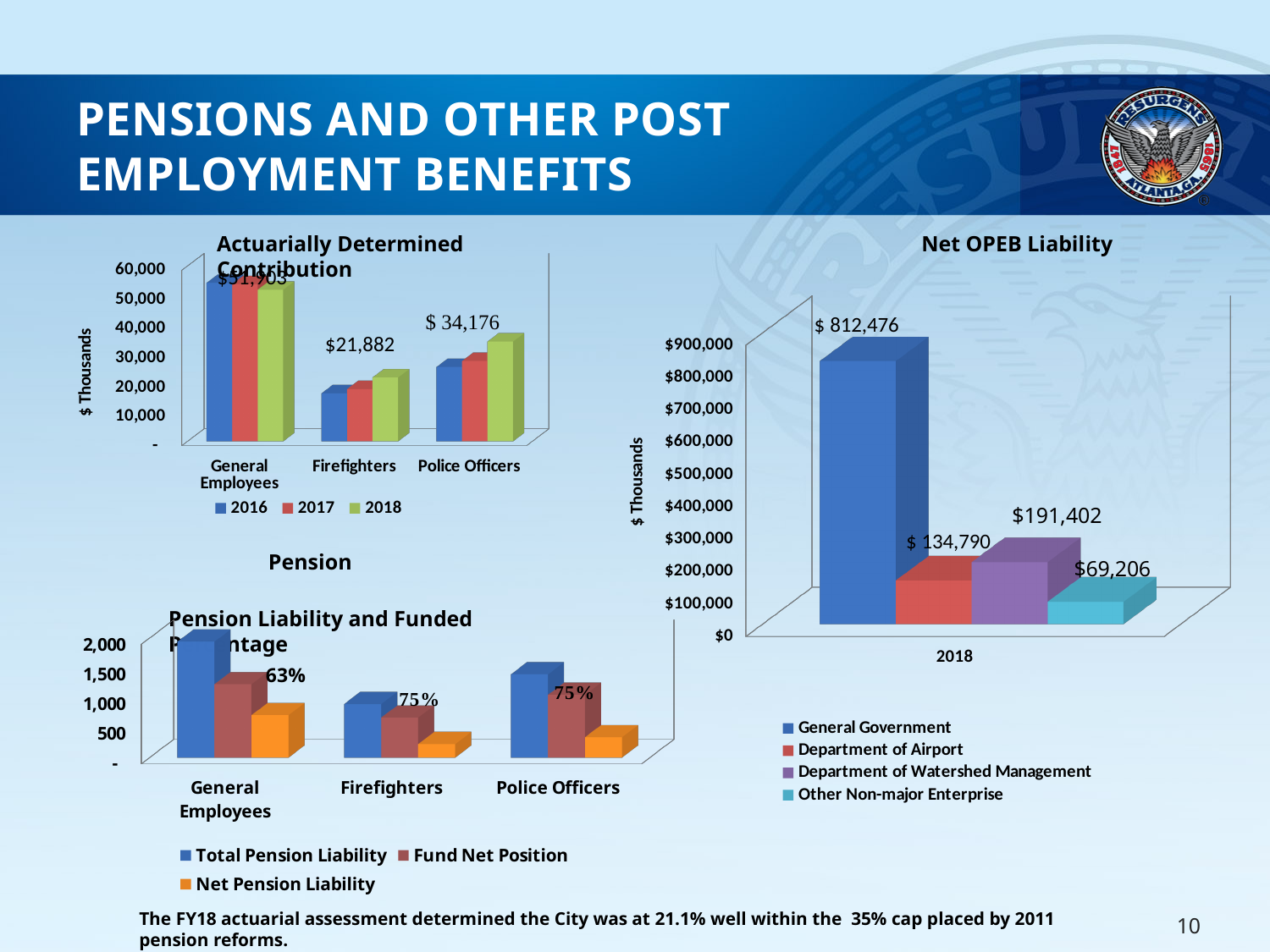
In the Pension Liability and Funded Percentage chart, is the Net Pension Liability for Firefighters greater or less than 500? less In the Pension Liability and Funded Percentage chart, is the Total Pension Liability for General Employees greater or less than 1,500? greater How many series does the legend of the Net OPEB Liability chart list? 4 How many series does the legend of the Actuarially Determined Contribution chart list? 3 In the Pension Liability and Funded Percentage chart, what funded percentage is shown for Firefighters? 75% In the Net OPEB Liability chart, which series has the lowest value? Other Non-major Enterprise In the Net OPEB Liability chart, what is the value for General Government? $812,476 In the Net OPEB Liability chart, what is the value for Other Non-major Enterprise? $69,206 In the Net OPEB Liability chart, what is the difference between Department of Watershed Management and Department of Airport? $56,612 What kind of chart is the Actuarially Determined Contribution chart? bar chart In the Net OPEB Liability chart, what is the value for Department of Watershed Management? $191,402 In the Pension Liability and Funded Percentage chart, what funded percentage is shown for General Employees? 63%